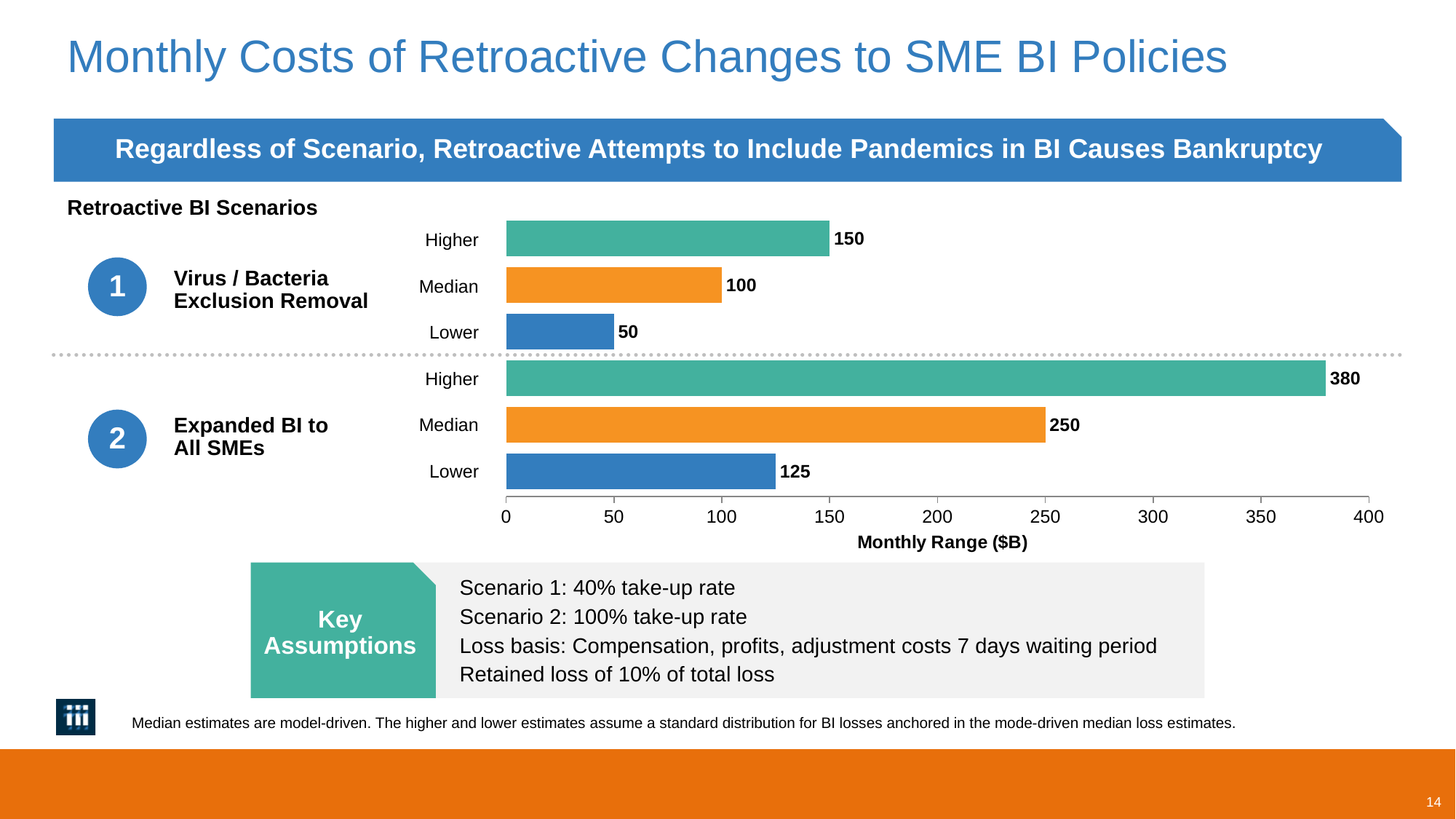
What is the difference between the Higher estimates of Scenario 2 and Scenario 1? 230 Which bar in the chart has the lowest value? Scenario 1 Lower (50) What kind of chart is shown on the slide? Bar chart What is the label of the horizontal axis of the chart? Monthly Range ($B) What is the Median estimate for Scenario 2 (Expanded BI to All SMEs)? 250 What is the difference between the Median and Lower estimates for Scenario 1? 50 Is the Higher estimate for Scenario 2 greater or less than 350? greater Which is larger: the Lower estimate for Scenario 2 or the Median estimate for Scenario 1? Lower estimate for Scenario 2 How many bars are plotted in the chart? 6 What is the Lower estimate for Scenario 2 (Expanded BI to All SMEs)? 125 Which bar in the chart has the highest value? Scenario 2 Higher (380) What is the Higher estimate for Scenario 1 (Virus / Bacteria Exclusion Removal)? 150